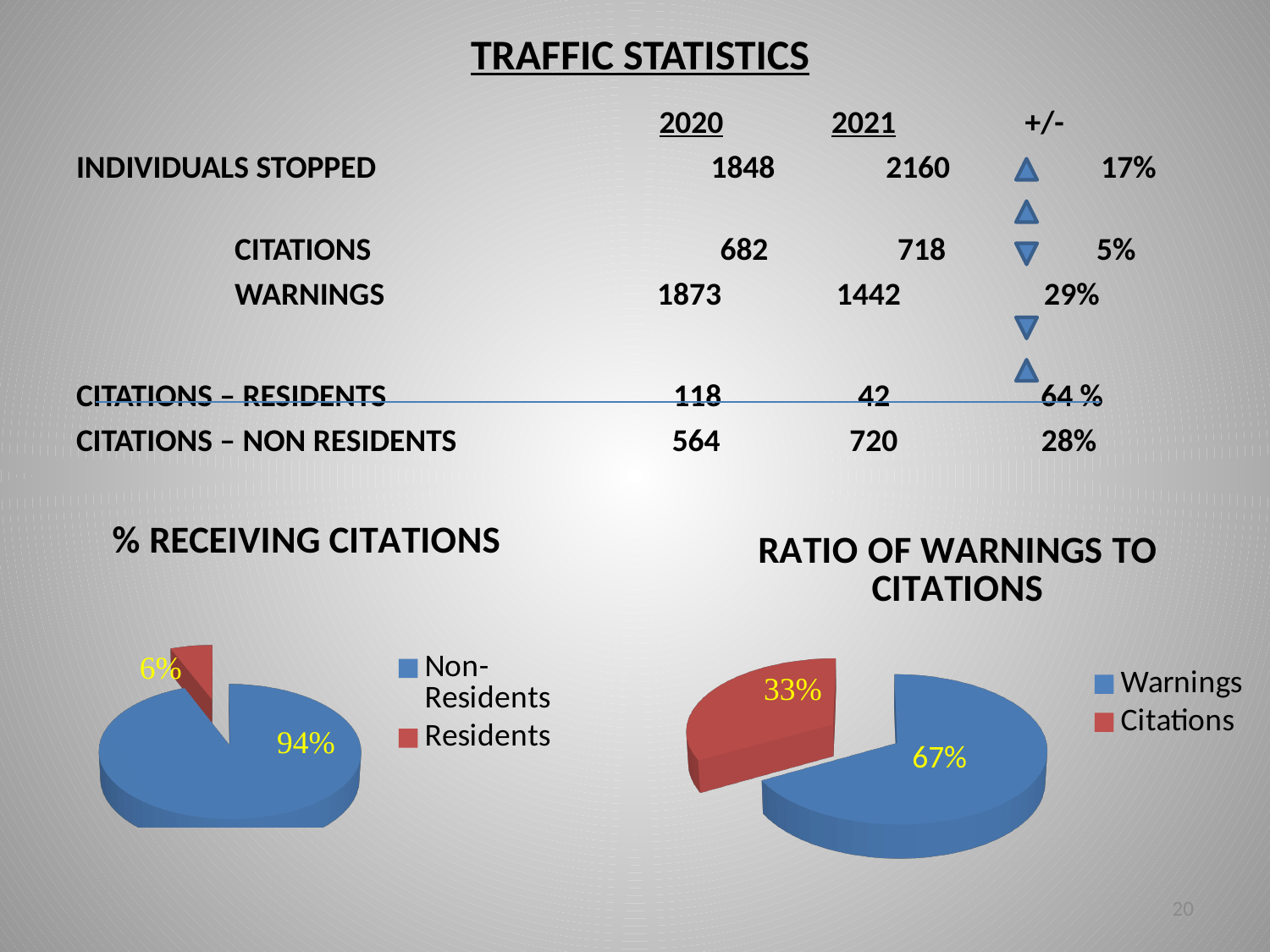
How many slices does the 'RATIO OF WARNINGS TO CITATIONS' pie chart have? 2 What type of chart is the '% RECEIVING CITATIONS' chart? Pie chart In the '% RECEIVING CITATIONS' pie chart, what is the difference in percentage points between the Non-Residents and Residents slices? 88 In the 'RATIO OF WARNINGS TO CITATIONS' pie chart, what share is labelled for Warnings? 67% In the '% RECEIVING CITATIONS' pie chart, what share is labelled for Residents? 6% In the '% RECEIVING CITATIONS' pie chart, which slice is the largest? Non-Residents In the '% RECEIVING CITATIONS' pie chart, what share is labelled for Non-Residents? 94% In the 'RATIO OF WARNINGS TO CITATIONS' pie chart, what is the difference in percentage points between the Warnings and Citations slices? 34 In the 'RATIO OF WARNINGS TO CITATIONS' pie chart, which slice is the smallest? Citations In the 'RATIO OF WARNINGS TO CITATIONS' pie chart, which is larger, Warnings or Citations? Warnings In the 'RATIO OF WARNINGS TO CITATIONS' pie chart, what share is labelled for Citations? 33% In the 'RATIO OF WARNINGS TO CITATIONS' pie chart, what colour is the Warnings slice? Blue